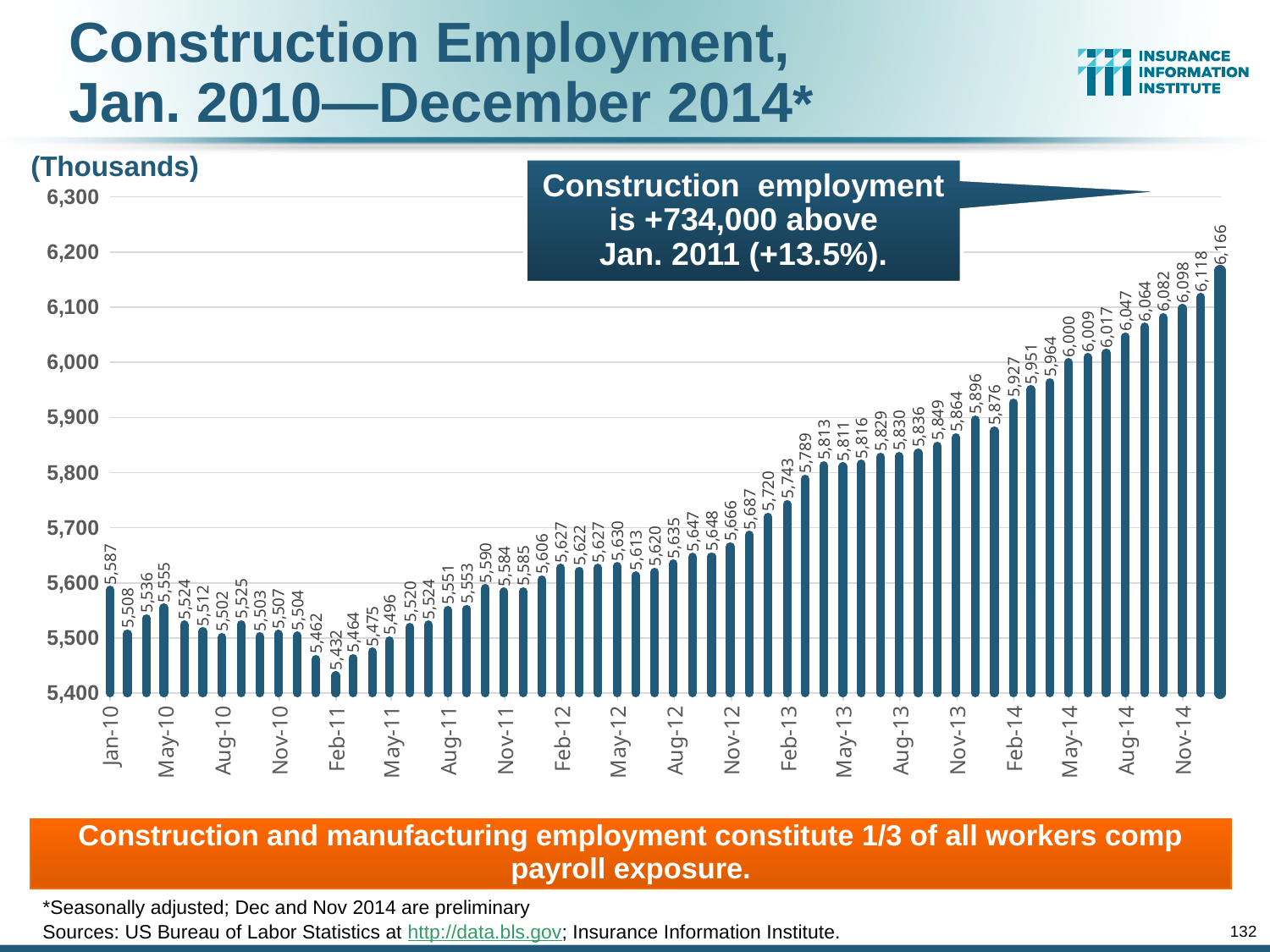
Is the value for Aug-14 greater or less than 6,000? greater What type of chart is shown on the slide? Bar chart What is the construction employment value for Jan-10? 5,587 What is the lowest value shown on the chart? 5,432 What is the highest value shown on the chart? 6,166 Do the values generally rise or fall from Feb-11 to Dec-14? Rise What is the construction employment value for Aug-13? 5,836 What is the construction employment value for Nov-14? 6,118 In what units are the values on the y-axis expressed? Thousands What is the difference between the values for Nov-14 and Jan-10? 531 Which is larger, the value for Aug-12 or the value for Aug-13? Aug-13 What is the construction employment value for Feb-11? 5,464